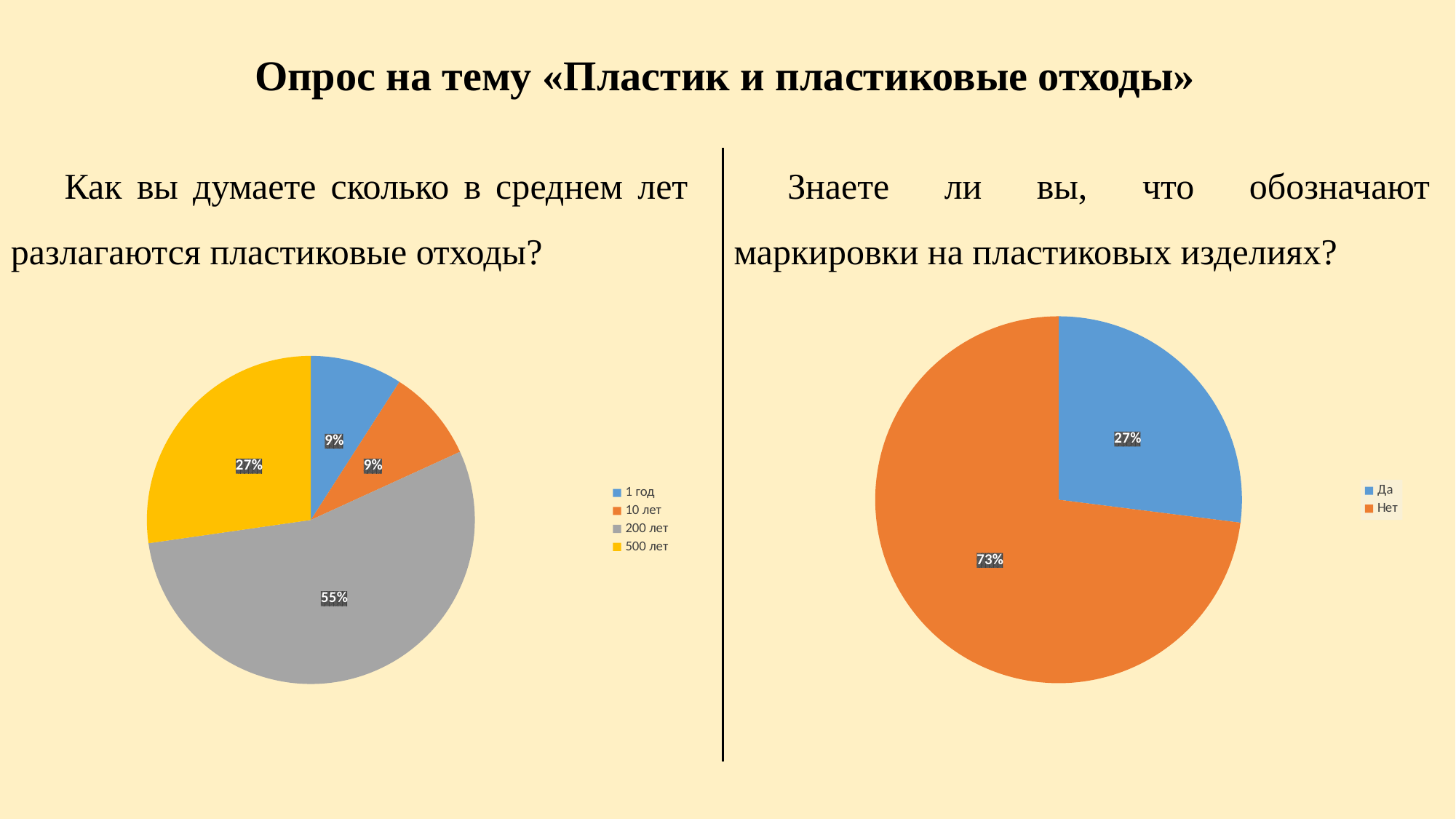
In the left pie chart, how many categories does the legend list? 4 In the left pie chart, what share is labelled for "1 год"? 9% What type of chart is shown on the right side of the slide? Pie chart In the left pie chart, which slice is larger: "500 лет" or "10 лет"? 500 лет In the right pie chart, what share is labelled for "Да"? 27% In the left pie chart (about how many years plastic waste takes to decompose), what share is labelled for "200 лет"? 55% In the left pie chart, which category has the largest slice? 200 лет In the left pie chart, what share is labelled for "500 лет"? 27% In the right pie chart, which answer has the smaller slice? Да In the left pie chart, what is the difference between the shares for "200 лет" and "500 лет"? 28% In the right pie chart, what is the difference between the shares for "Нет" and "Да"? 46% In the right pie chart (about plastic markings), what share is labelled for "Нет"? 73%